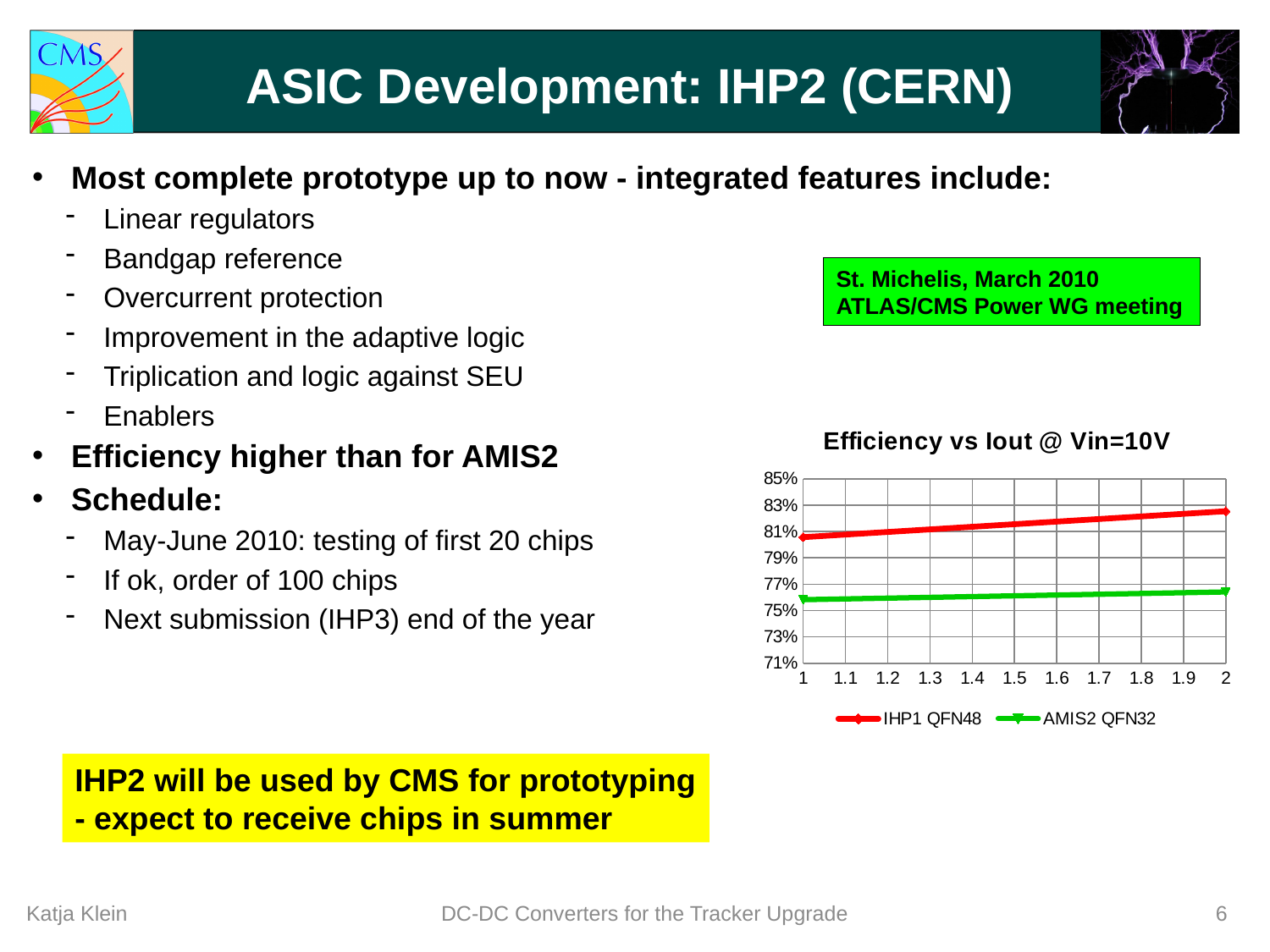
Which series is drawn in red in the chart? IHP1 QFN48 Does the efficiency of IHP1 QFN48 rise or fall as Iout increases from 1 to 2? rise Which series has the higher efficiency at Iout = 1.5? IHP1 QFN48 What kind of chart is shown on the slide? line chart Is the efficiency of AMIS2 QFN32 at Iout = 1 greater or less than 73%? greater Is the efficiency of IHP1 QFN48 at Iout = 2 greater or less than 81%? greater What is the title of the chart on the slide? Efficiency vs Iout @ Vin=10V Is the efficiency of AMIS2 QFN32 at Iout = 2 greater or less than 79%? less Which series has the lower efficiency across the whole Iout range shown? AMIS2 QFN32 How many series does the chart legend list? 2 How many tick labels are shown on the x axis of the chart? 11